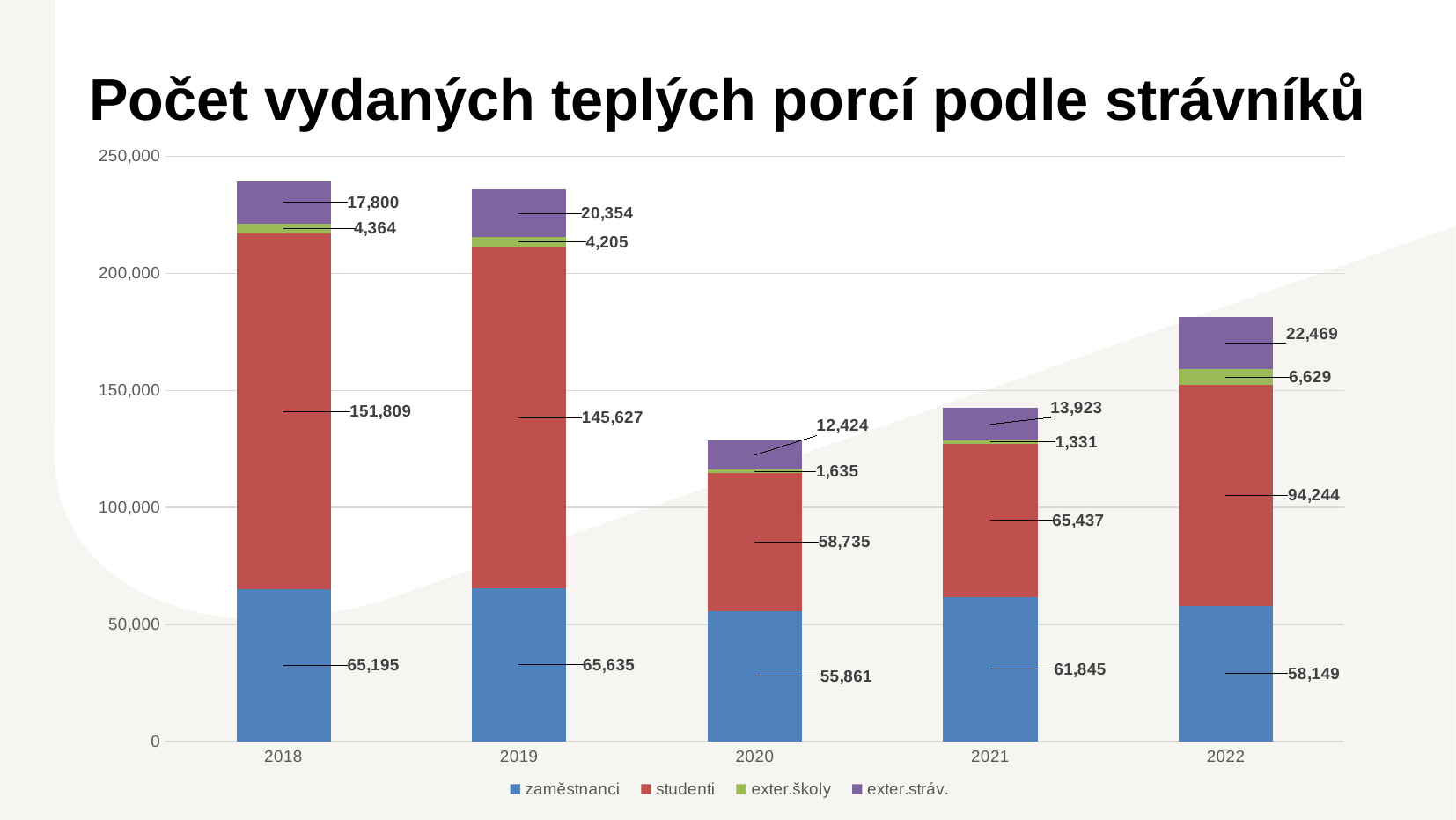
What is the value for exter.školy in 2021? 1,331 What is the difference between the studenti values for 2018 and 2019? 6,182 What is the value for zaměstnanci in 2020? 55,861 How many series does the legend list? 4 How many years are shown on the x axis? 5 What is the value for studenti in 2018? 151,809 What is the value for exter.stráv. in 2022? 22,469 What kind of chart is shown on the slide? Stacked bar chart Which year has the lowest value for exter.školy? 2021 What is the total of the stacked bar for 2020? 128,655 Which is larger: the zaměstnanci value in 2021 or in 2022? 2021 Which year has the highest value for studenti? 2018